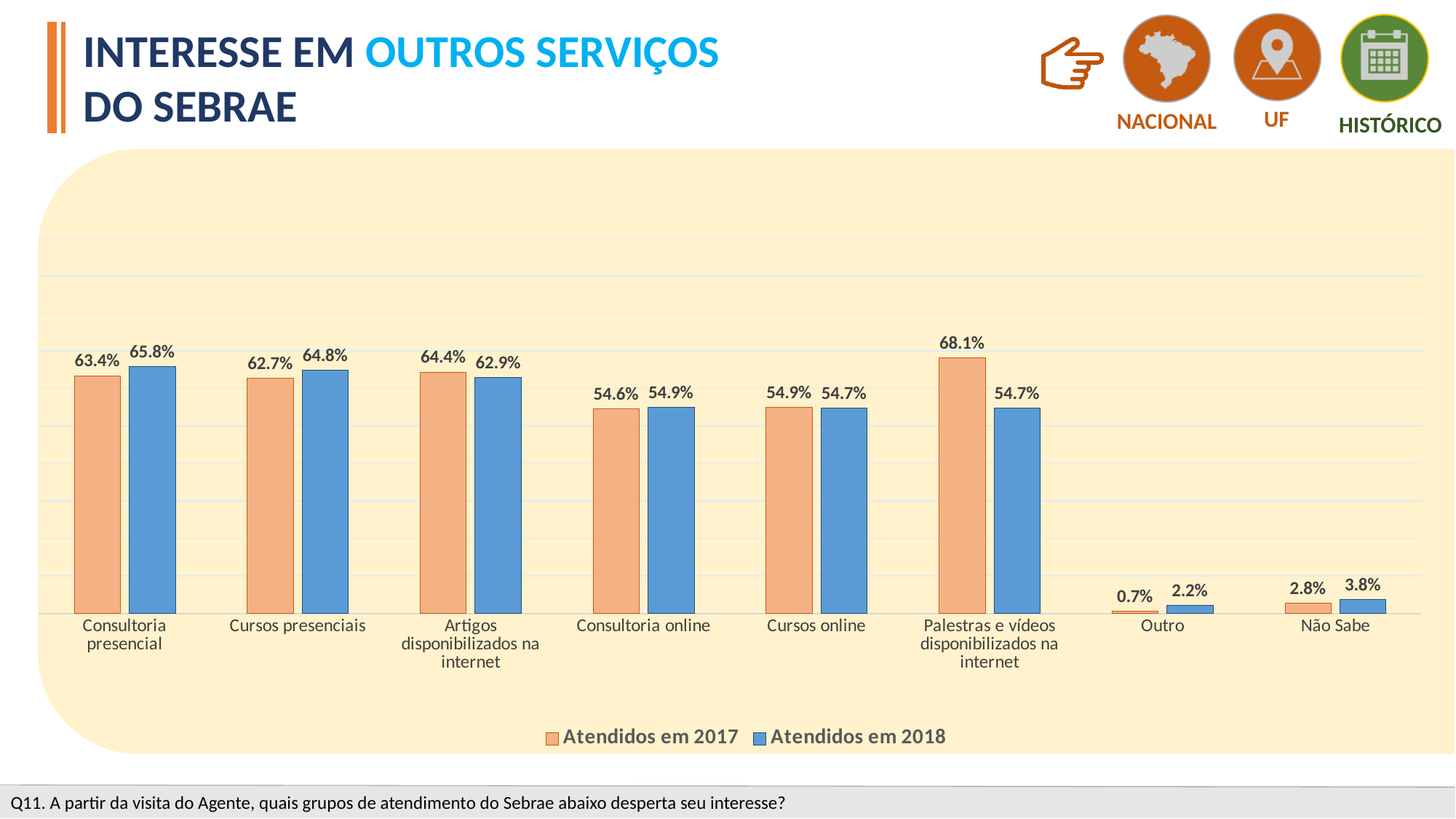
How many series does the legend list? 2 What is the difference between the Atendidos em 2018 and Atendidos em 2017 values for Cursos presenciais? 2.1% Which colour represents the Atendidos em 2018 series? Blue Which category has the highest value in the Atendidos em 2017 series? Palestras e vídeos disponibilizados na internet For Artigos disponibilizados na internet, which series has the larger value, Atendidos em 2017 or Atendidos em 2018? Atendidos em 2017 What is the value for Palestras e vídeos disponibilizados na internet in the Atendidos em 2018 series? 54.7% How many categories are shown on the x axis of the chart? 8 Which category has the lowest value in the Atendidos em 2018 series? Outro What is the difference between the Atendidos em 2017 and Atendidos em 2018 values for Palestras e vídeos disponibilizados na internet? 13.4% What is the value for Outro in the Atendidos em 2017 series? 0.7% What kind of chart is shown on the slide? Bar chart What is the value for Consultoria presencial in the Atendidos em 2017 series? 63.4%